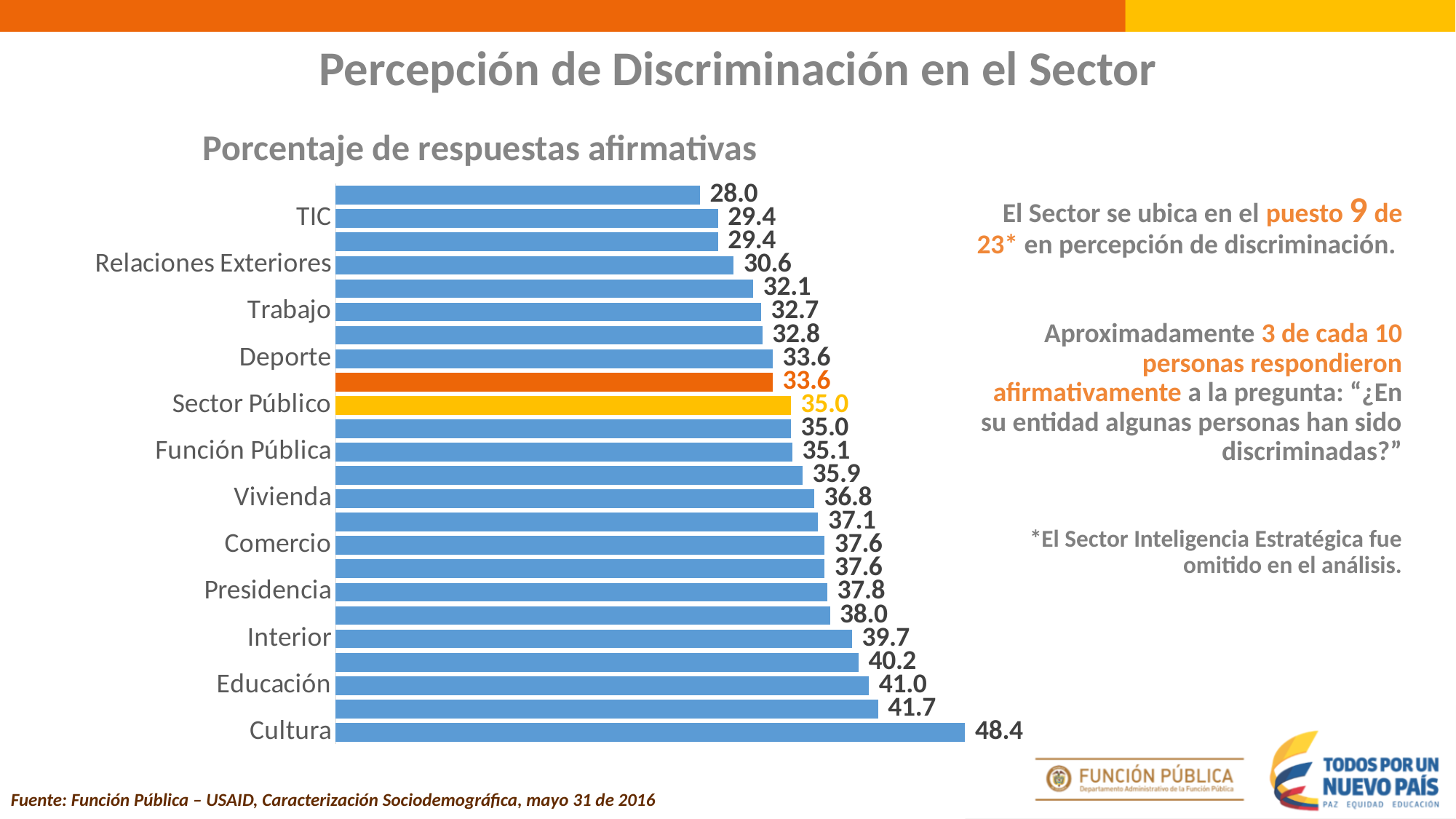
Which labelled category has the highest value? Cultura What kind of chart is shown on the slide? Bar chart How many bars are plotted on the chart? 24 What is the value for Interior? 39.7 What colour is the bar for Sector Público? Yellow What is the title of the chart? Porcentaje de respuestas afirmativas Which is larger, the value for Educación or the value for Vivienda? Educación What is the value for Sector Público? 35.0 What is the difference between the values for Cultura and Educación? 7.4 What is the lowest value shown on the chart? 28.0 What is the value for Cultura? 48.4 What is the value for Trabajo? 32.7